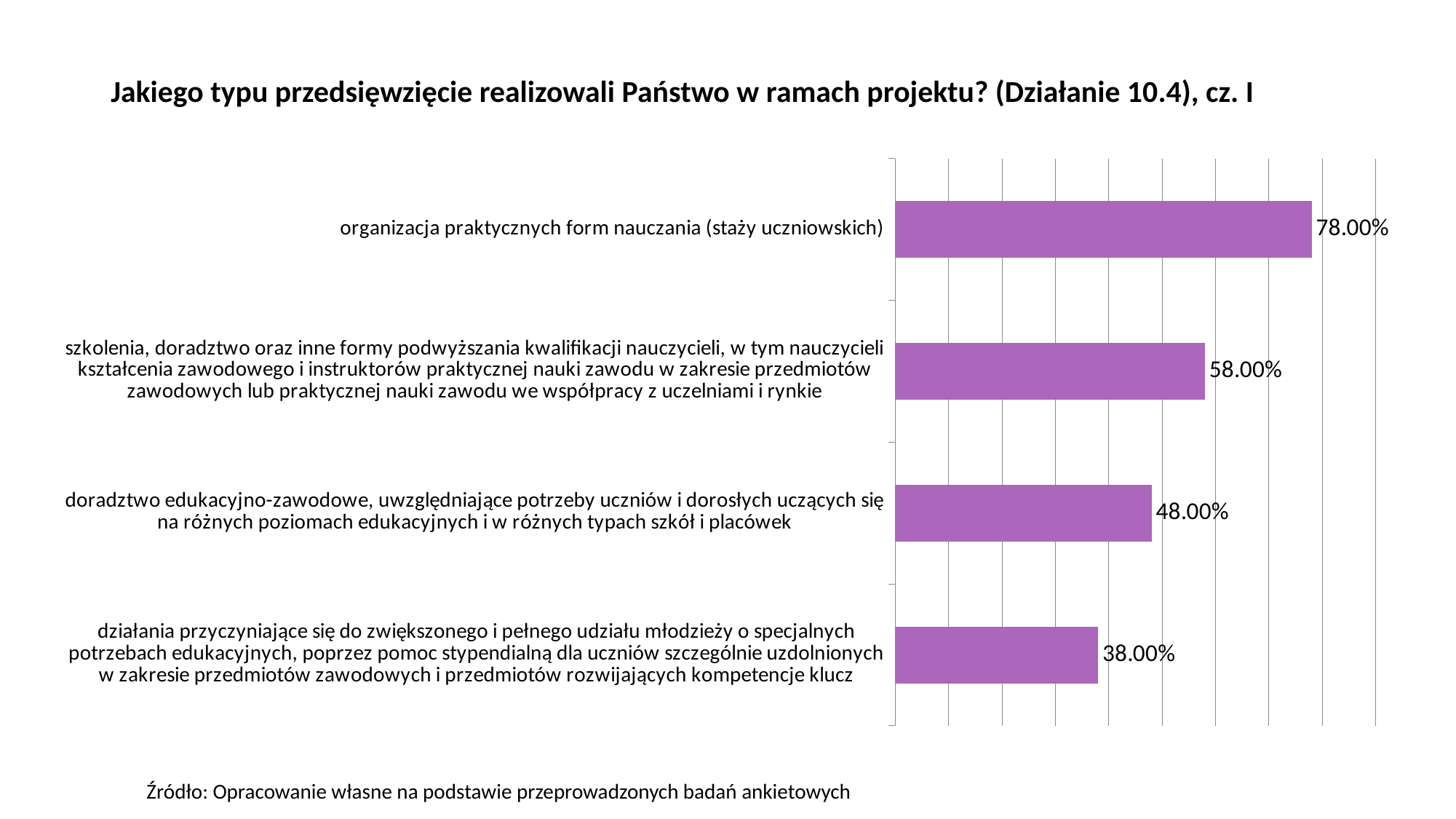
How many categories are shown in the chart? 4 What is the difference between the value for "szkolenia, doradztwo oraz inne formy podwyższania kwalifikacji nauczycieli" and the value for "działania przyczyniające się do zwiększonego i pełnego udziału młodzieży"? 20.00% What is the difference between the value for "organizacja praktycznych form nauczania" and the value for "doradztwo edukacyjno-zawodowe"? 30.00% Which category has the highest value? organizacja praktycznych form nauczania (staży uczniowskich) Which is larger: the value for "szkolenia, doradztwo oraz inne formy podwyższania kwalifikacji nauczycieli" or the value for "doradztwo edukacyjno-zawodowe"? szkolenia, doradztwo oraz inne formy podwyższania kwalifikacji nauczycieli Which category has the lowest value? działania przyczyniające się do zwiększonego i pełnego udziału młodzieży o specjalnych potrzebach edukacyjnych What is the value for the category about "działania przyczyniające się do zwiększonego i pełnego udziału młodzieży o specjalnych potrzebach edukacyjnych"? 38.00% What is the value for "organizacja praktycznych form nauczania (staży uczniowskich)"? 78.00% What is the value for the category about "doradztwo edukacyjno-zawodowe"? 48.00% What is the value for the category about "szkolenia, doradztwo oraz inne formy podwyższania kwalifikacji nauczycieli"? 58.00% What kind of chart is shown on the slide? bar chart What is the title of the chart? Jakiego typu przedsięwzięcie realizowali Państwo w ramach projektu? (Działanie 10.4), cz. I